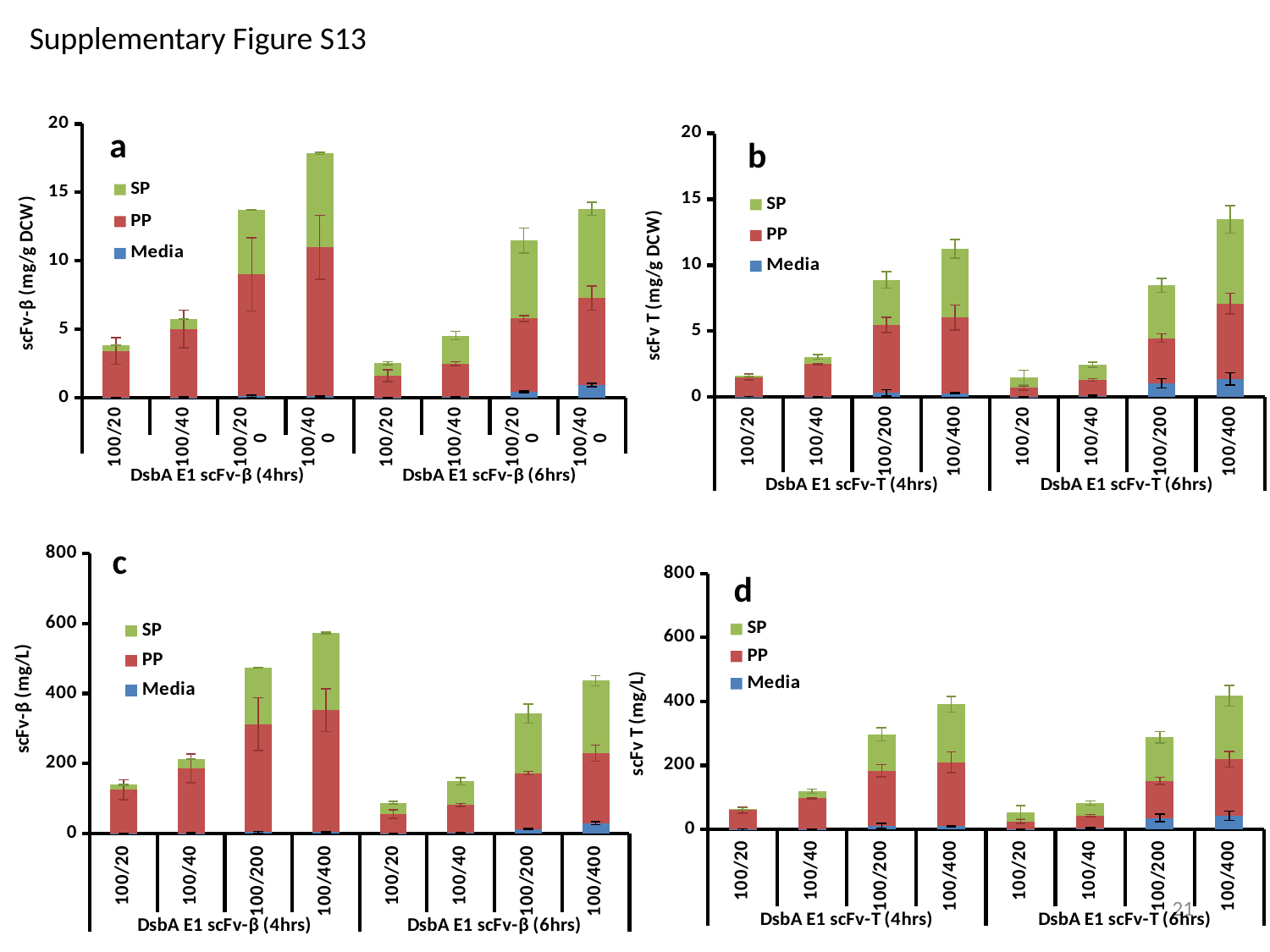
In chart d (bottom right), is the total for 100/200 under DsbA E1 scFv-T (4hrs) greater or less than 200? greater In chart b (top right), is the total for 100/400 under DsbA E1 scFv-T (6hrs) greater or less than 10? greater In chart c (bottom left), is the total for 100/20 under DsbA E1 scFv-β (6hrs) greater or less than 200? less What is the y-axis label of chart d (bottom right)? scFv T (mg/L) In chart c (bottom left), which is larger: the total for 100/200 at 4hrs or the total for 100/200 at 6hrs? 100/200 at 4hrs What kind of chart is chart a (top left)? stacked bar chart In chart b (top right), how many series does the legend list? 3 In chart c (bottom left), which bar has the highest total? 100/400 under DsbA E1 scFv-β (4hrs) In chart c (bottom left), how many bars are plotted? 8 In chart a (top left), which bar has the highest total? 100/400 under DsbA E1 scFv-β (4hrs) In chart a (top left), which bar has the lowest total? 100/20 under DsbA E1 scFv-β (6hrs)